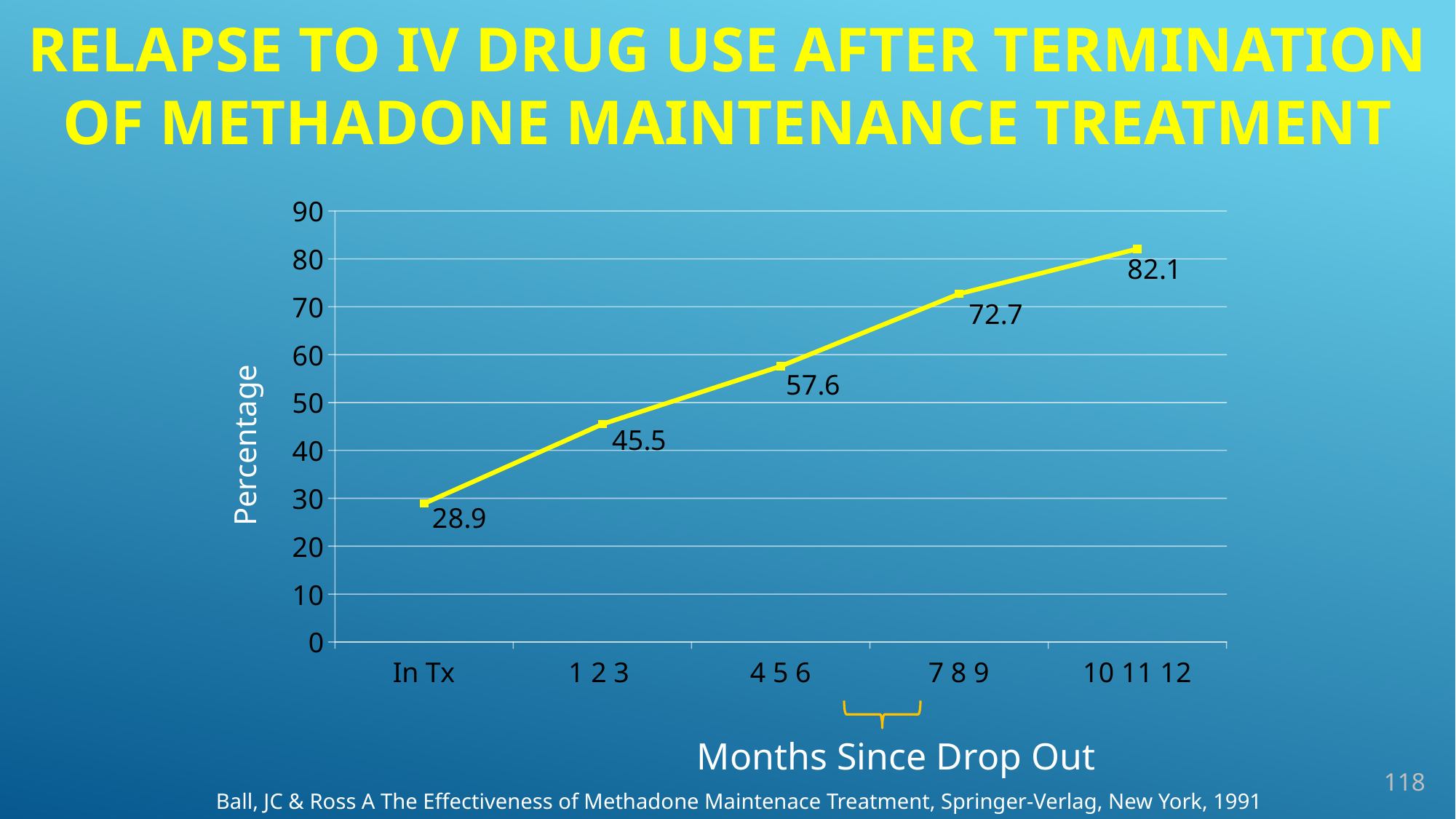
What is the difference between the percentage at '7 8 9' months and at '4 5 6' months? 15.1 How many data points are plotted on the line? 5 What is the percentage value for the 'In Tx' category? 28.9 What is the percentage value at '4 5 6' months since drop out? 57.6 What kind of chart is shown on the slide? line chart Which category has the highest percentage? 10 11 12 What is the difference between the percentage at '10 11 12' months and the percentage for 'In Tx'? 53.2 Do the values rise or fall along the x axis from 'In Tx' to '10 11 12'? rise Which category has the lowest percentage? In Tx What is the percentage value at '10 11 12' months since drop out? 82.1 Which is larger, the percentage at '1 2 3' months or at '7 8 9' months? 7 8 9 Is the value at '1 2 3' months greater or less than 50? less